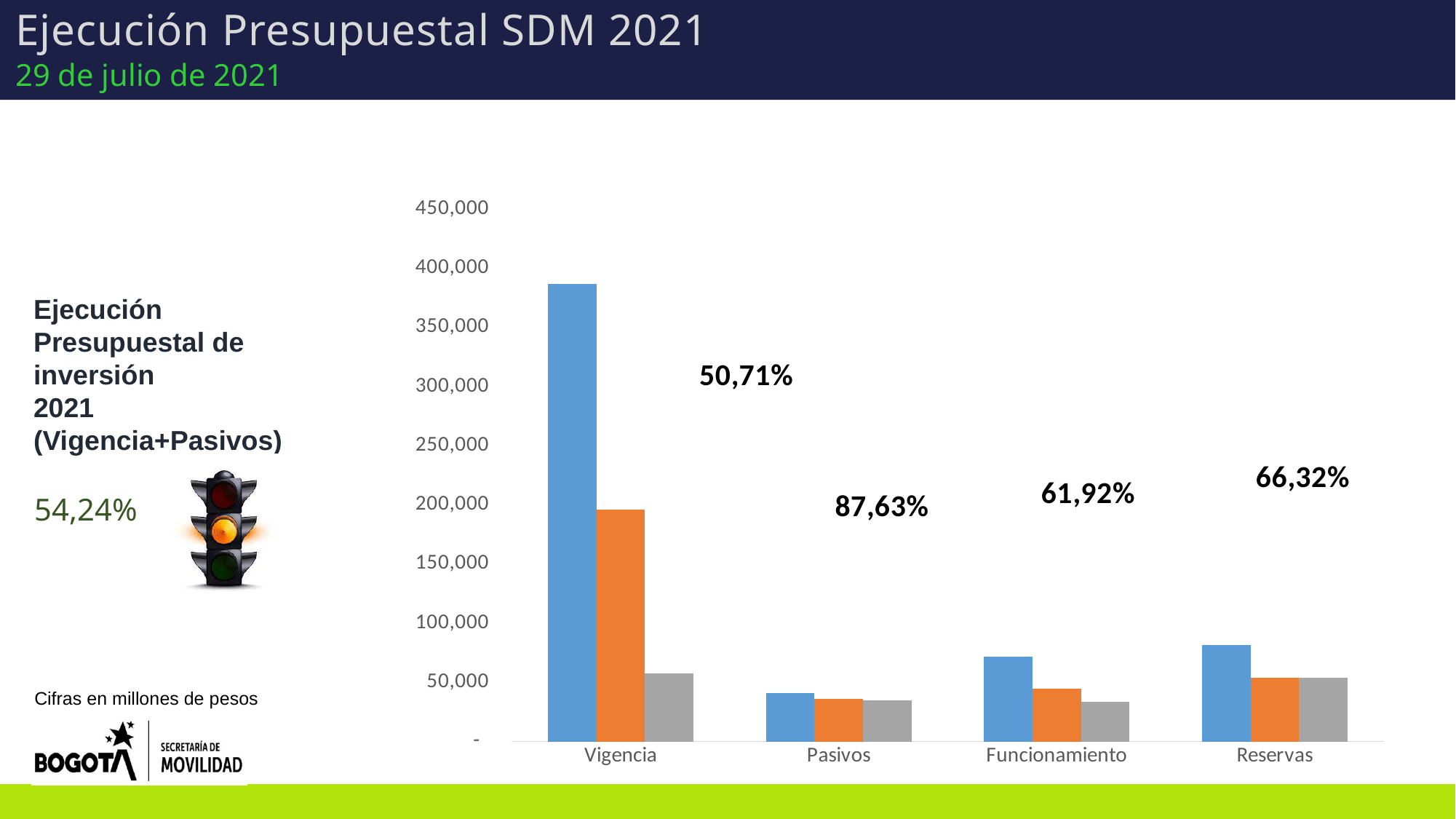
Which category has the lowest percentage label in the chart? Vigencia What percentage label is shown above the Pasivos group in the chart? 87,63% How many categories are shown on the x axis of the chart? 4 Is the value of the blue bar for Pasivos greater or less than 50,000? less What type of chart is shown on the slide? bar chart Which category has the highest percentage label in the chart? Pasivos Which category has the tallest blue bar in the chart? Vigencia What is the difference between the percentage labels for Pasivos and Vigencia? 36,92% What percentage label is shown above the Vigencia group in the chart? 50,71% What percentage label is shown above the Reservas group in the chart? 66,32% What percentage label is shown above the Funcionamiento group in the chart? 61,92% Is the value of the blue bar for Vigencia greater or less than 350,000? greater